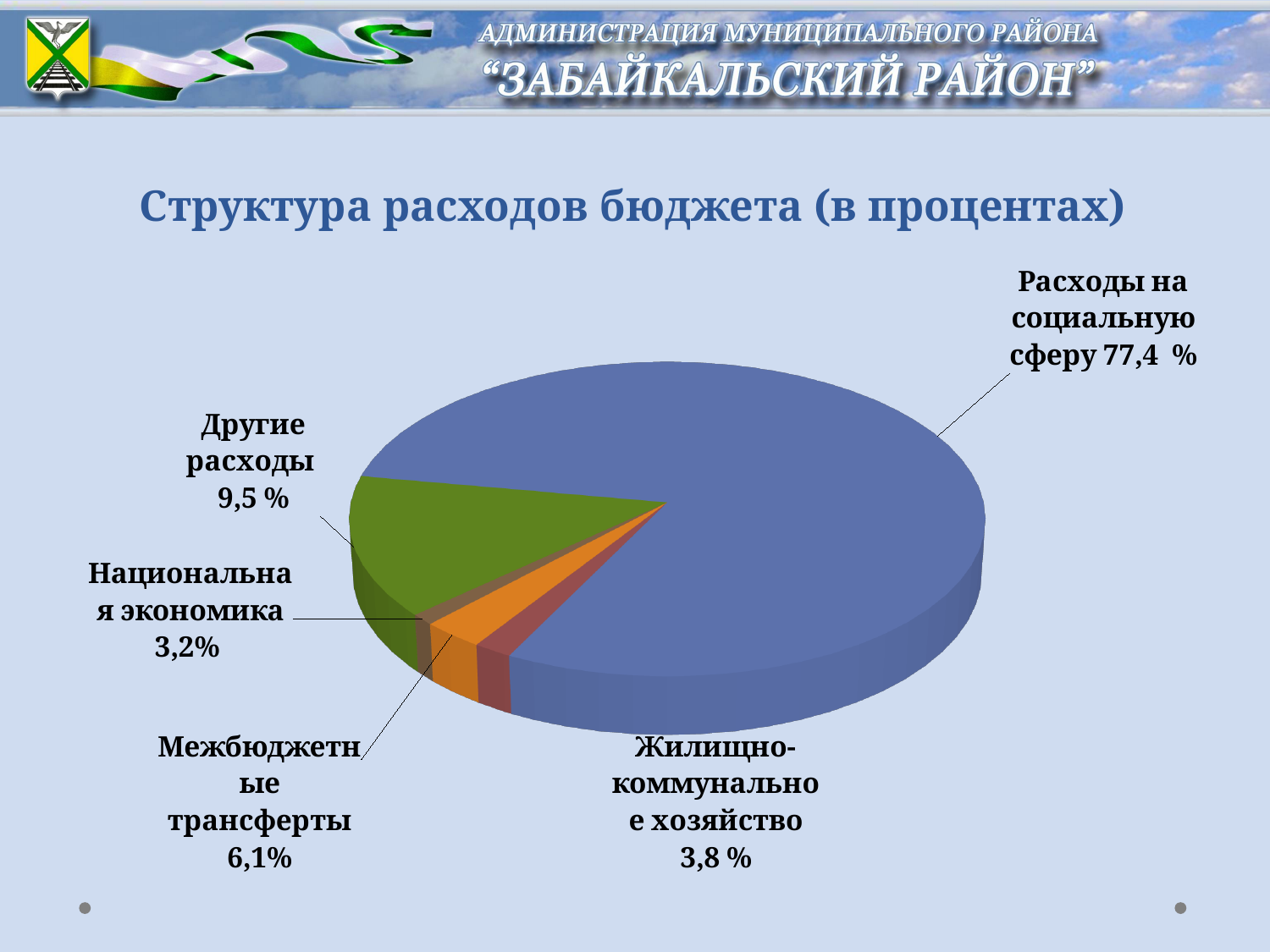
Which category has the largest share of the pie? Расходы на социальную сферу What kind of chart is shown on the slide? Pie chart What is the value shown for Другие расходы? 9,5 % What share of budget expenditures goes to Расходы на социальную сферу? 77,4 % What is the difference in percentage points between Расходы на социальную сферу and Другие расходы? 67,9 How many slices does the pie chart have? 5 Which is larger: Межбюджетные трансферты or Жилищно-коммунальное хозяйство? Межбюджетные трансферты What is the value shown for Жилищно-коммунальное хозяйство? 3,8 % What is the title of the chart? Структура расходов бюджета (в процентах) What is the difference in percentage points between Межбюджетные трансферты and Национальная экономика? 2,9 What is the value shown for Межбюджетные трансферты? 6,1% Which category has the smallest share of the pie? Национальная экономика